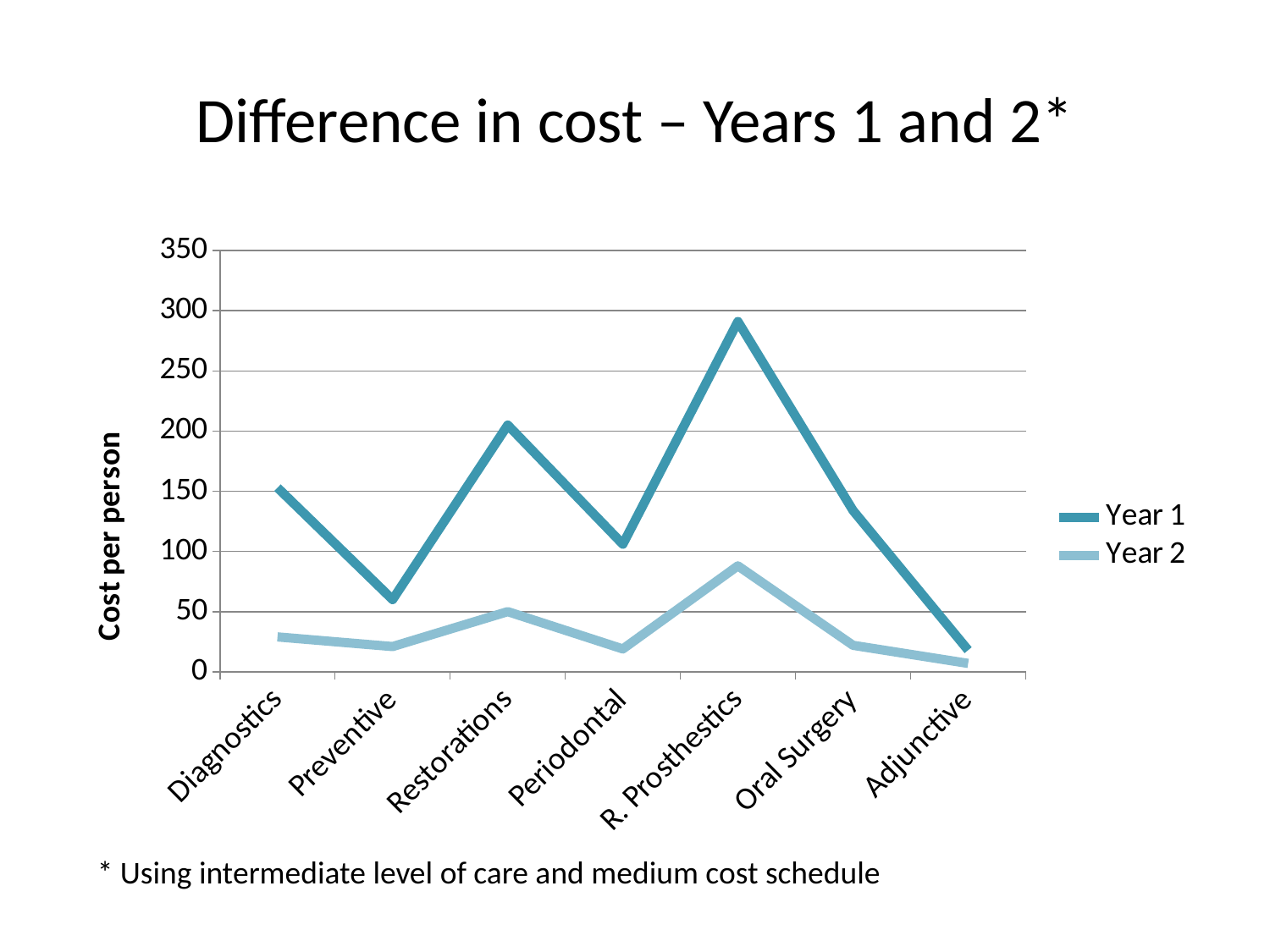
Is the Year 2 value for R. Prosthestics greater or less than 50? greater How many series does the legend list? 2 Which category has the highest Year 2 cost per person? R. Prosthestics Is the Year 1 value for R. Prosthestics greater or less than 250? greater Which category has the highest Year 1 cost per person? R. Prosthestics What is the title of the vertical axis? Cost per person For Year 1, which is larger: Restorations or Periodontal? Restorations What kind of chart is shown on the slide? Line chart How many categories are shown on the x axis? 7 Is the Year 1 value for Preventive greater or less than 100? less Does the Year 1 line rise or fall from R. Prosthestics to Adjunctive? Fall Which category has the lowest Year 1 cost per person? Adjunctive